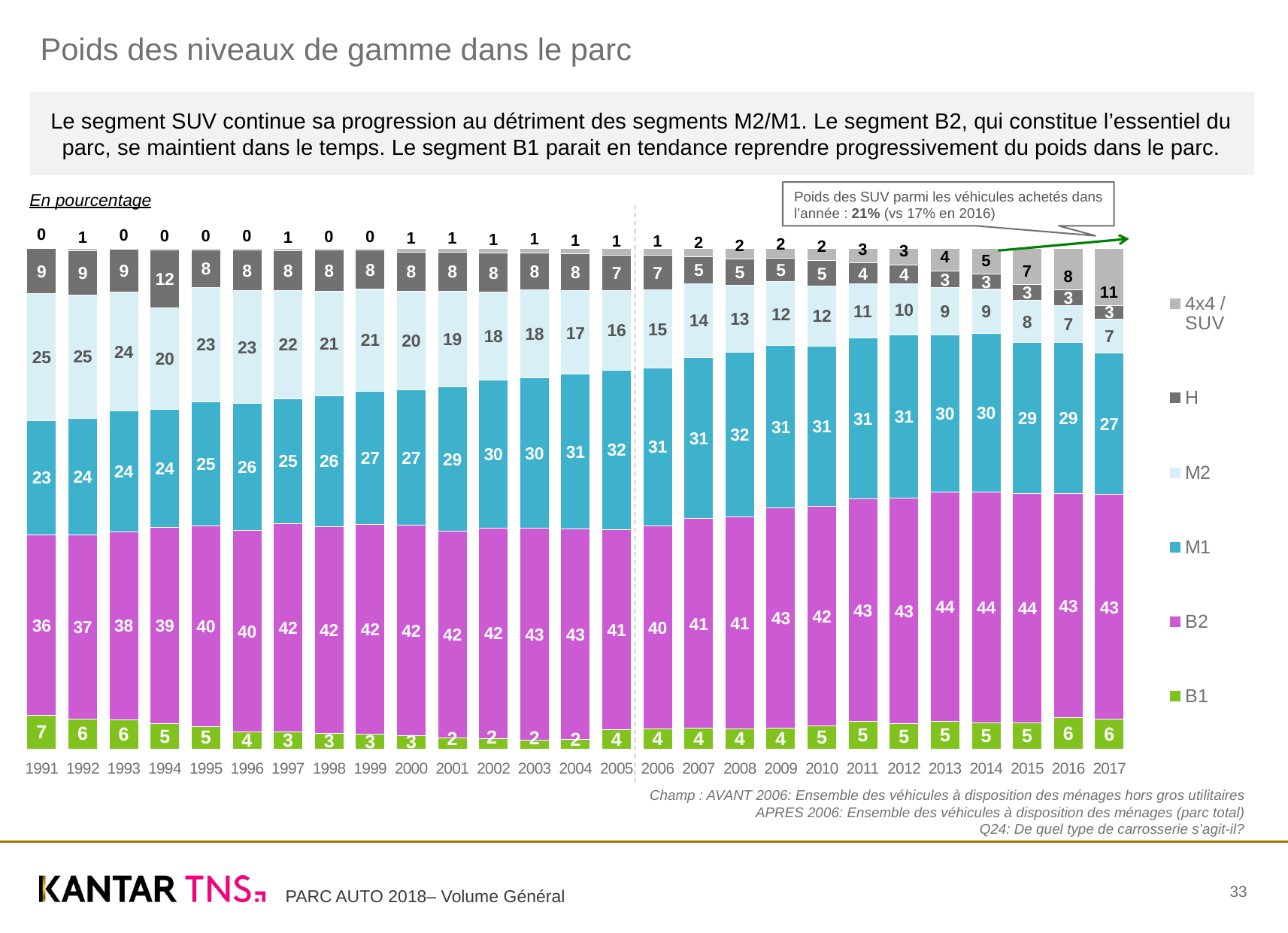
In which year is the B1 segment highest? 1991 How many years are shown on the x axis? 27 Does the M2 segment rise or fall from 1991 to 2017? Fall What kind of chart is shown on the slide? Stacked bar chart In which year is the 4x4 / SUV segment highest? 2017 What is the value for B2 in 2017? 43 What is the value for 4x4 / SUV in 2017? 11 What is the value for H in 1994? 12 What is the total of the stacked bar for 1991? 100 What is the difference between the M2 value in 1991 and the M2 value in 2017? 18 How many series does the legend list? 6 Which is larger, the M1 value in 2005 or the M1 value in 2017? 2005